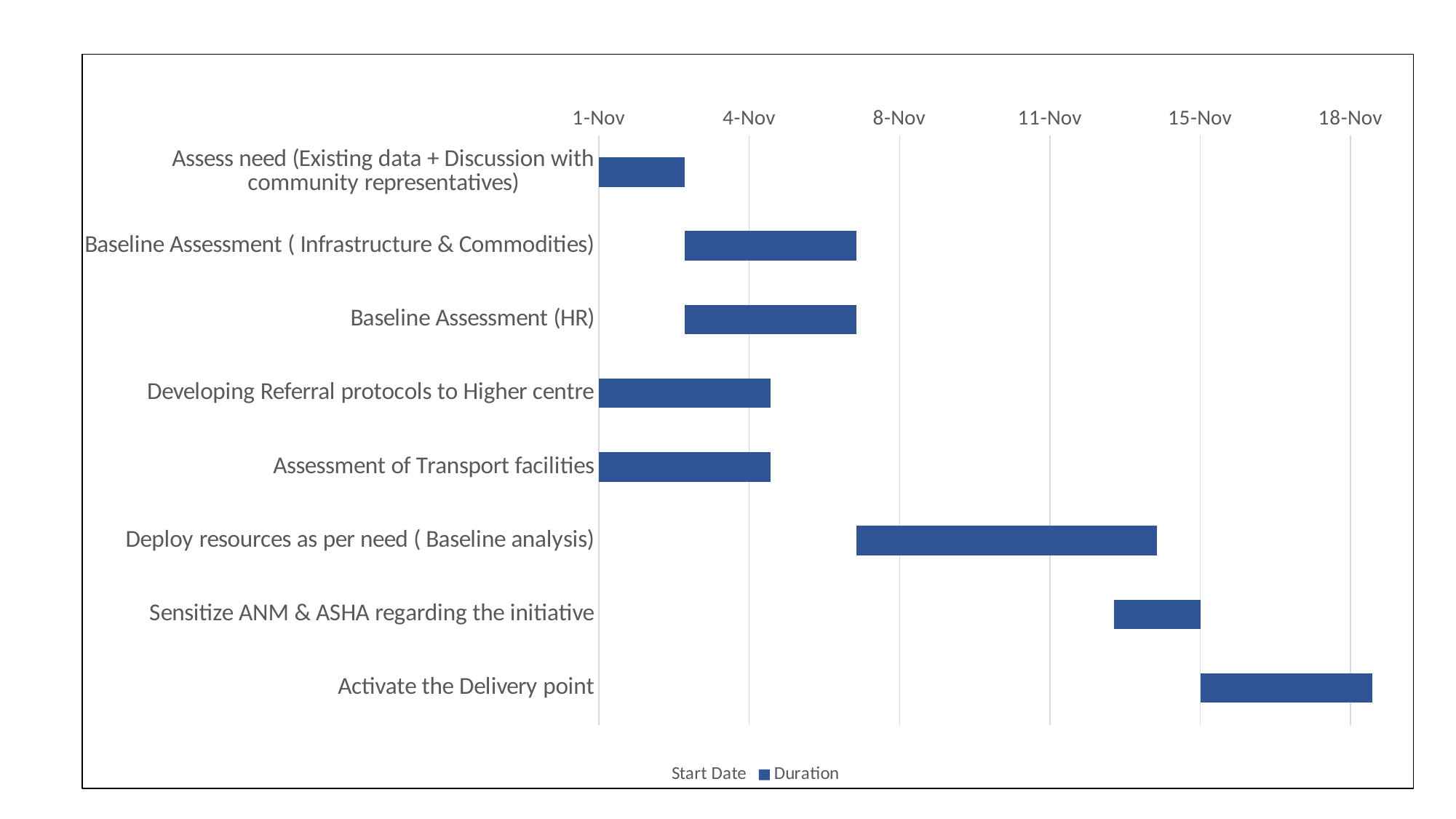
Does the bar for 'Sensitize ANM & ASHA regarding the initiative' start before or after 11-Nov? after Which task has the longest bar in the chart? Deploy resources as per need ( Baseline analysis) Is the bar for 'Baseline Assessment ( Infrastructure & Commodities)' longer or shorter than the bar for 'Sensitize ANM & ASHA regarding the initiative'? longer Does the bar for 'Deploy resources as per need ( Baseline analysis)' end before or after 15-Nov? before How many series does the chart legend list? 2 What kind of chart is shown on the slide? Bar chart Which task's bar starts latest on the date axis? Activate the Delivery point Does the bar for 'Baseline Assessment (HR)' end before or after 8-Nov? before Is the bar for 'Deploy resources as per need ( Baseline analysis)' longer or shorter than the bar for 'Assess need (Existing data + Discussion with community representatives)'? longer What are the two entries shown in the chart legend? Start Date and Duration How many tasks (categories) are listed on the vertical axis of the chart? 8